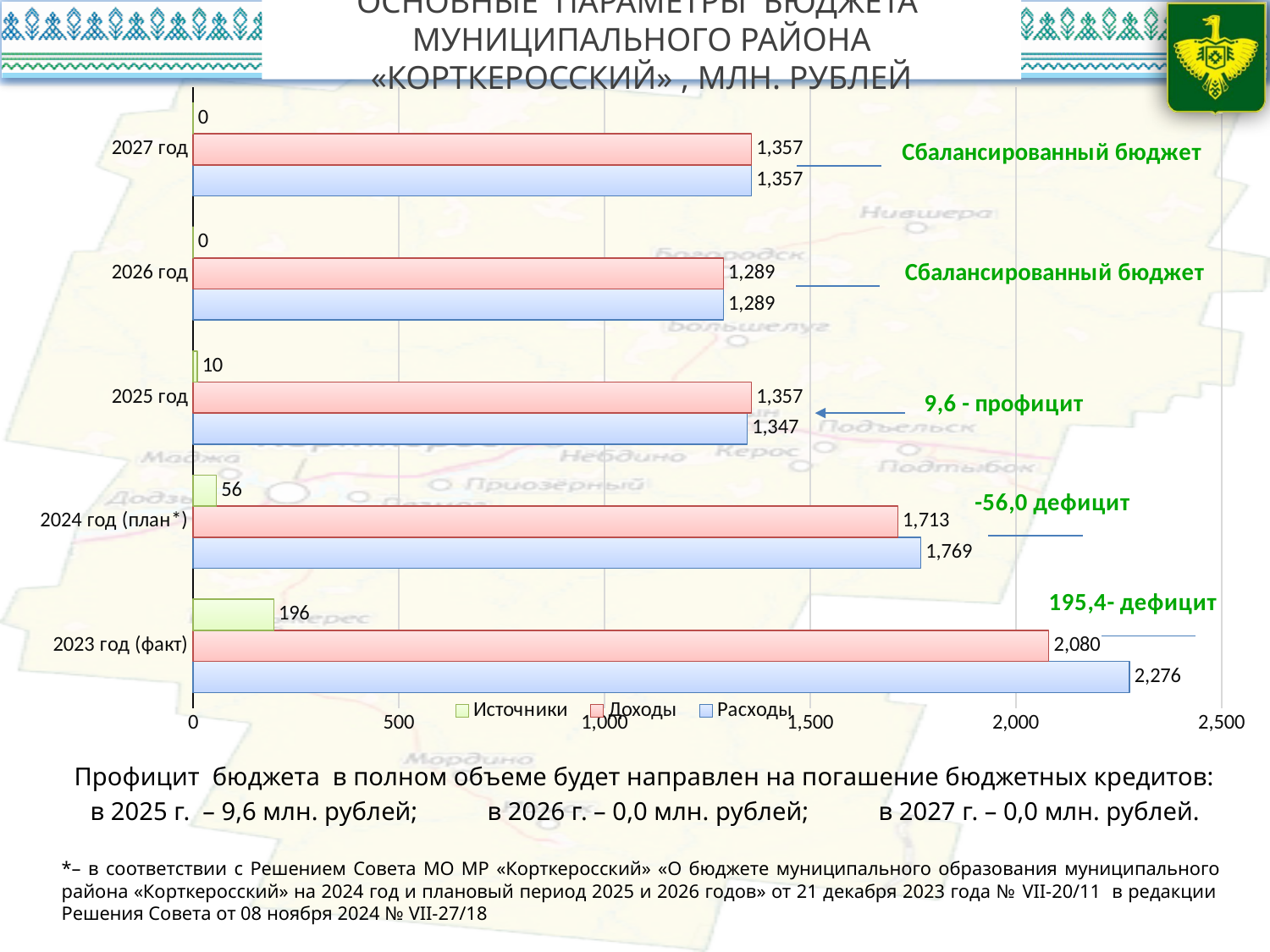
Which year has the lowest value of Расходы? 2026 год How many series does the legend list? 3 What is the value of Источники for 2025 год? 10 What type of chart is shown on the slide? bar chart How many year categories are shown on the chart? 5 What is the value of Расходы for 2023 год (факт)? 2,276 Is the value of Доходы for 2026 год greater or less than 1,500? less Which is larger for 2024 год (план*): Доходы or Расходы? Расходы What is the value of Доходы for 2024 год (план*)? 1,713 Which series is shown in green in the legend? Источники What is the difference between Расходы and Доходы for 2023 год (факт)? 196 Which year has the highest value of Доходы? 2023 год (факт)